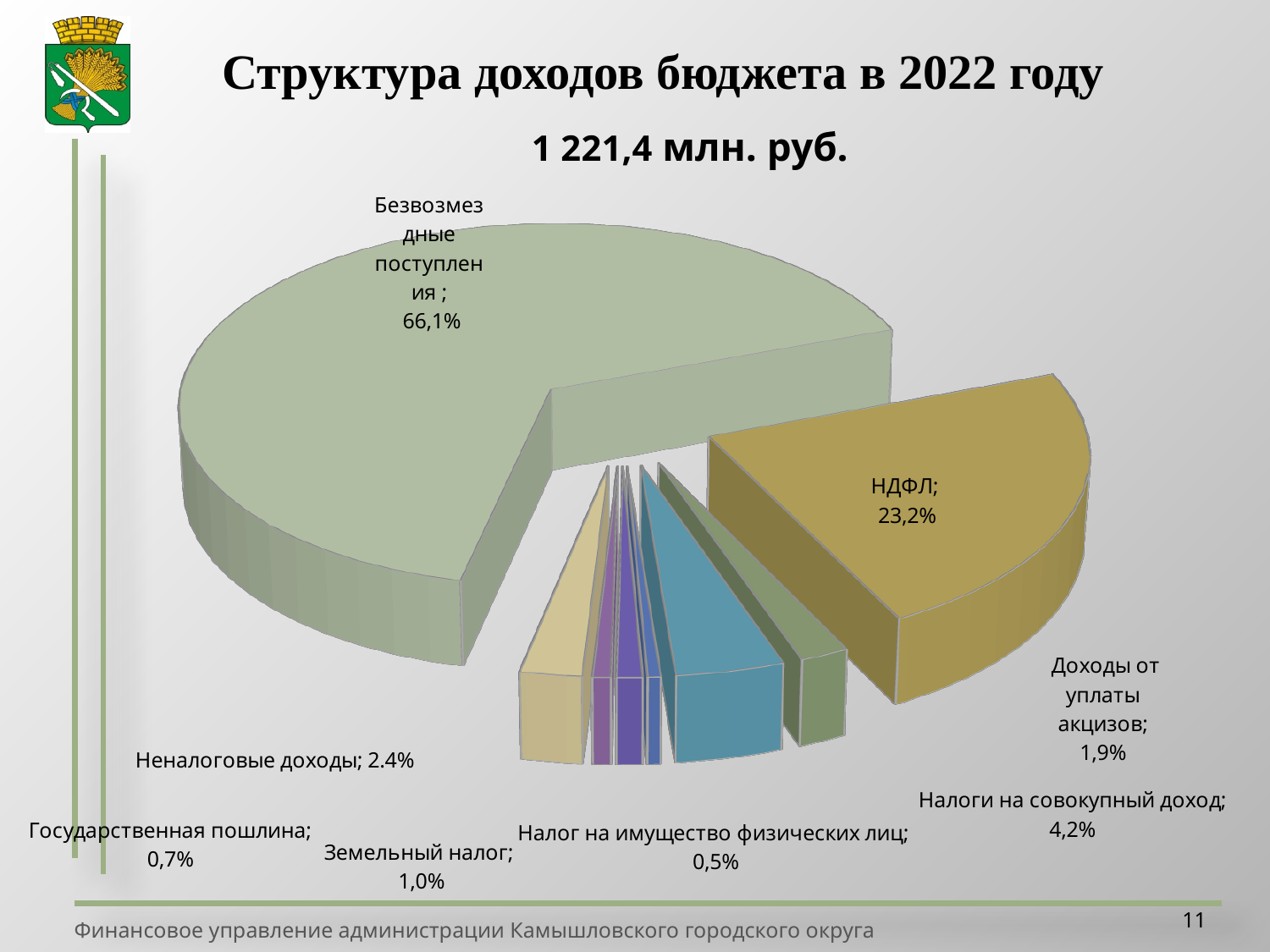
What type of chart is shown on the slide? pie chart How many categories are shown in the pie chart? 8 Which is larger: the share of Неналоговые доходы or the share of Земельный налог? Неналоговые доходы What share is shown for Налог на имущество физических лиц? 0,5% What is the difference in percentage points between the shares of Безвозмездные поступления and НДФЛ? 42,9 What percentage is shown for Налоги на совокупный доход? 4,2% What share of budget revenue is НДФЛ? 23,2% What share of budget revenue in 2022 comes from Безвозмездные поступления? 66,1% Which category has the smallest share of the pie? Налог на имущество физических лиц Which category has the largest share of the pie? Безвозмездные поступления What percentage is shown for Доходы от уплаты акцизов? 1,9% What total amount of budget revenue is stated above the chart? 1 221,4 млн. руб.